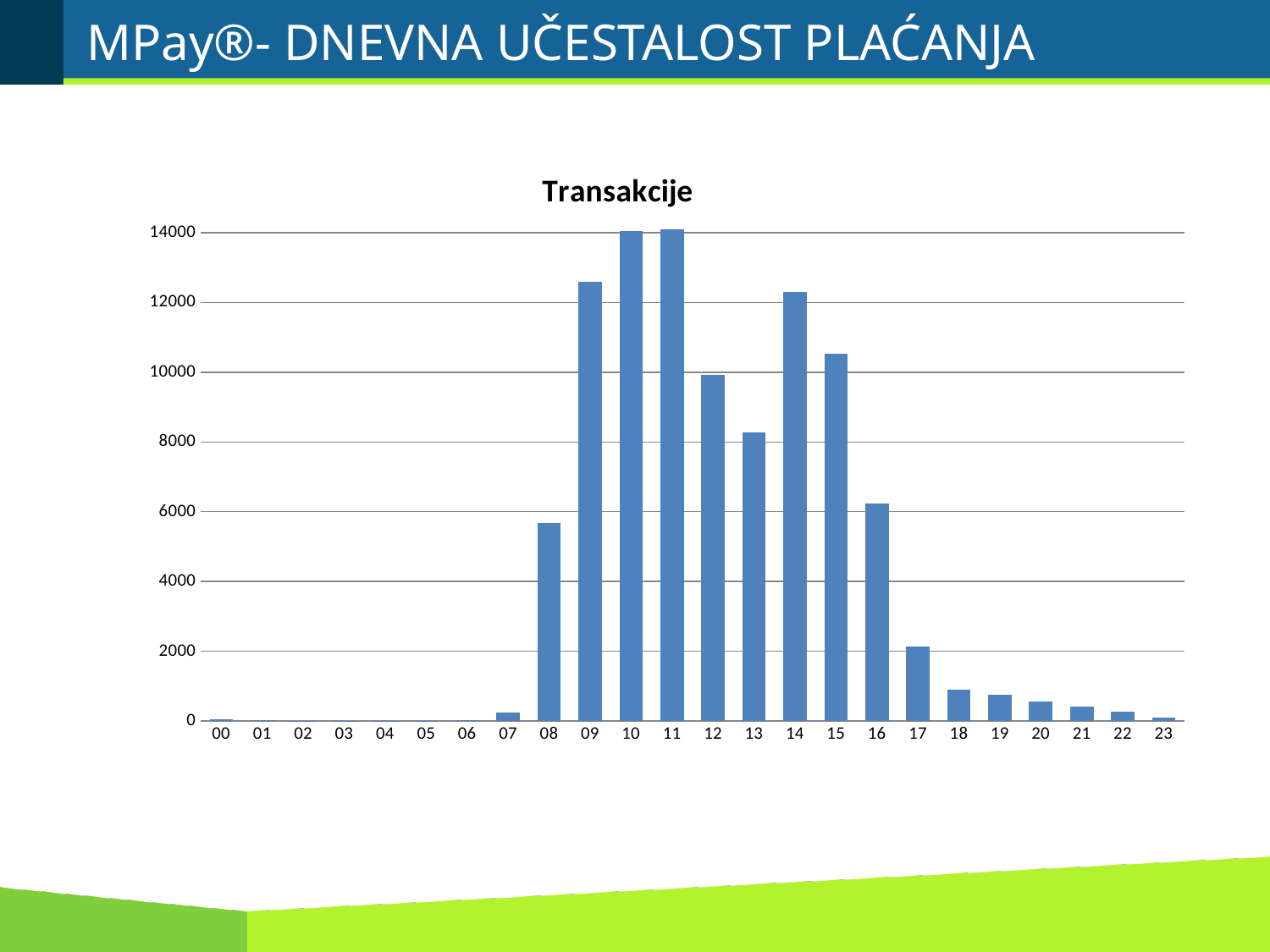
What kind of chart is shown on the slide? bar chart What is the title of the chart? Transakcije Which hour has the larger value, 08 or 09? 09 Is the value for hour 08 greater or less than 6000? less Is the value for hour 09 greater or less than 12000? greater Which hour has the larger value, 13 or 14? 14 Is the value for hour 13 greater or less than 10000? less How many hour categories are shown on the x axis of the chart? 24 Do the values rise or fall from hour 16 to hour 23? fall Do the values rise or fall from hour 07 to hour 10? rise